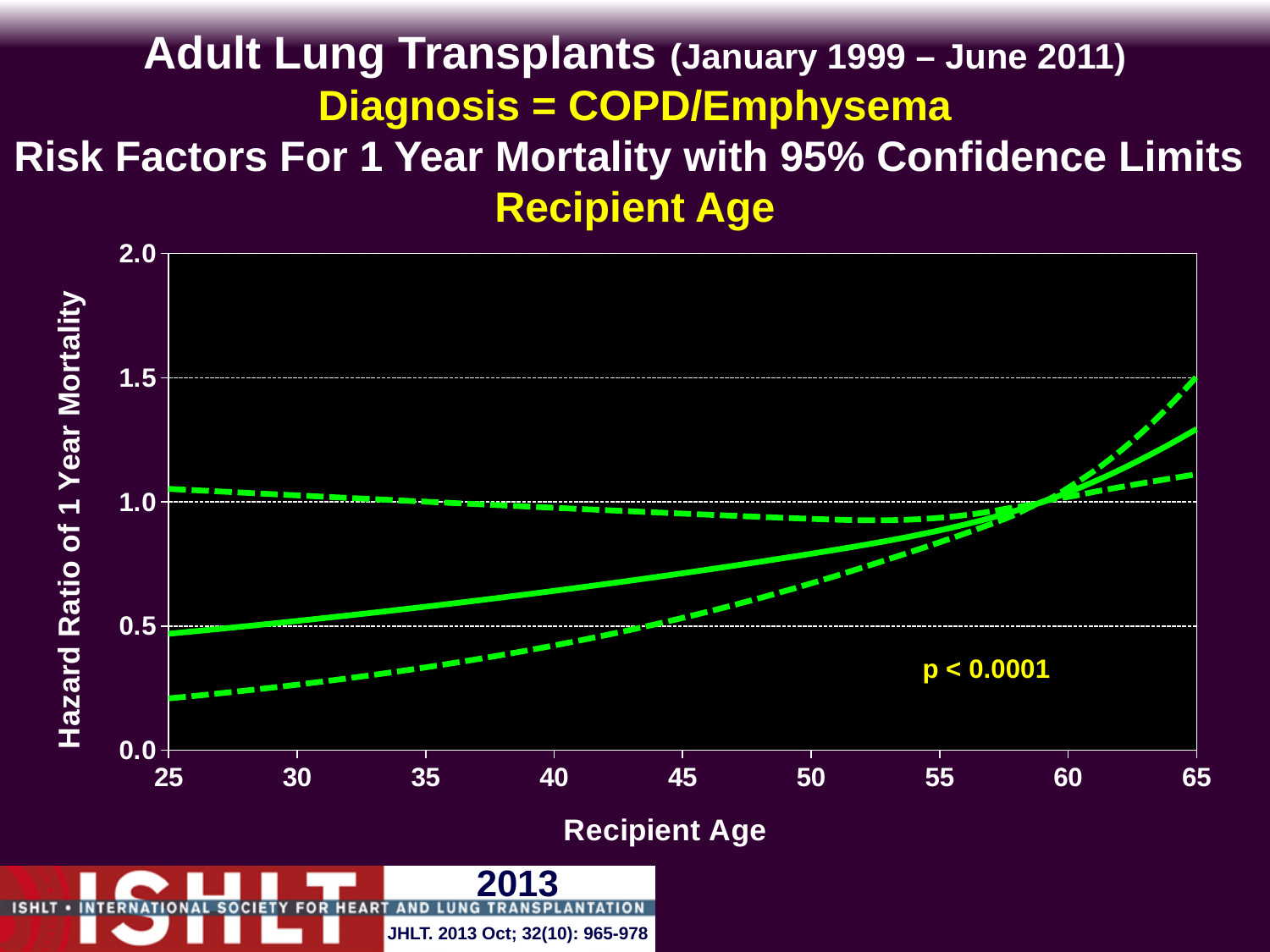
Is the lower confidence limit (lower dashed line) at recipient age 25 greater or less than 0.5? less Is the hazard ratio (solid line) at recipient age 45 greater or less than 1.0? less Is the hazard ratio (solid line) at recipient age 65 greater or less than 1.0? greater How many lines are plotted on the chart? 3 What p-value is printed on the chart? p < 0.0001 What is the label of the y axis? Hazard Ratio of 1 Year Mortality Does the solid hazard ratio line rise or fall as recipient age increases from 25 to 65? rise What kind of chart is shown on the slide? line chart Does the lower confidence limit (lower dashed line) rise or fall as recipient age increases? rise